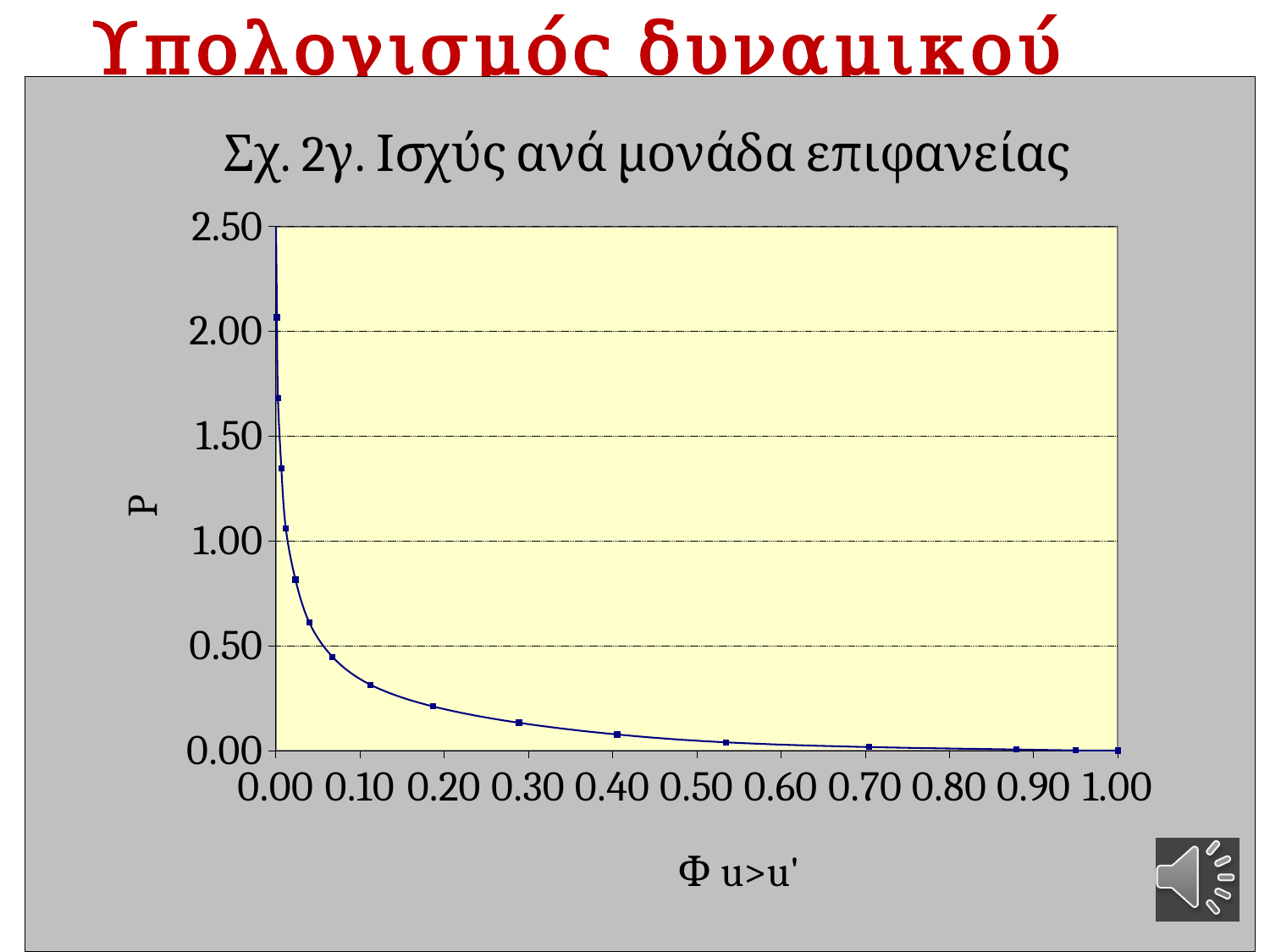
What kind of chart is shown on the slide? line chart Is the value of P at Φ u>u' = 1.00 greater or less than 0.50? less Do the values of P rise or fall as Φ u>u' increases along the x axis? fall Is the value of P at Φ u>u' = 0.50 greater or less than 0.50? less Which has the larger P value: the point at Φ u>u' = 0.10 or the point at Φ u>u' = 0.70? the point at 0.10 What is the highest tick value shown on the vertical axis? 2.50 Is the value of P at Φ u>u' = 0.30 greater or less than 1.00? less At which end of the x axis is the value of P highest, near 0.00 or near 1.00? near 0.00 What is the title of the chart? Σχ. 2γ. Ισχύς ανά μονάδα επιφανείας What is the label of the vertical axis? P